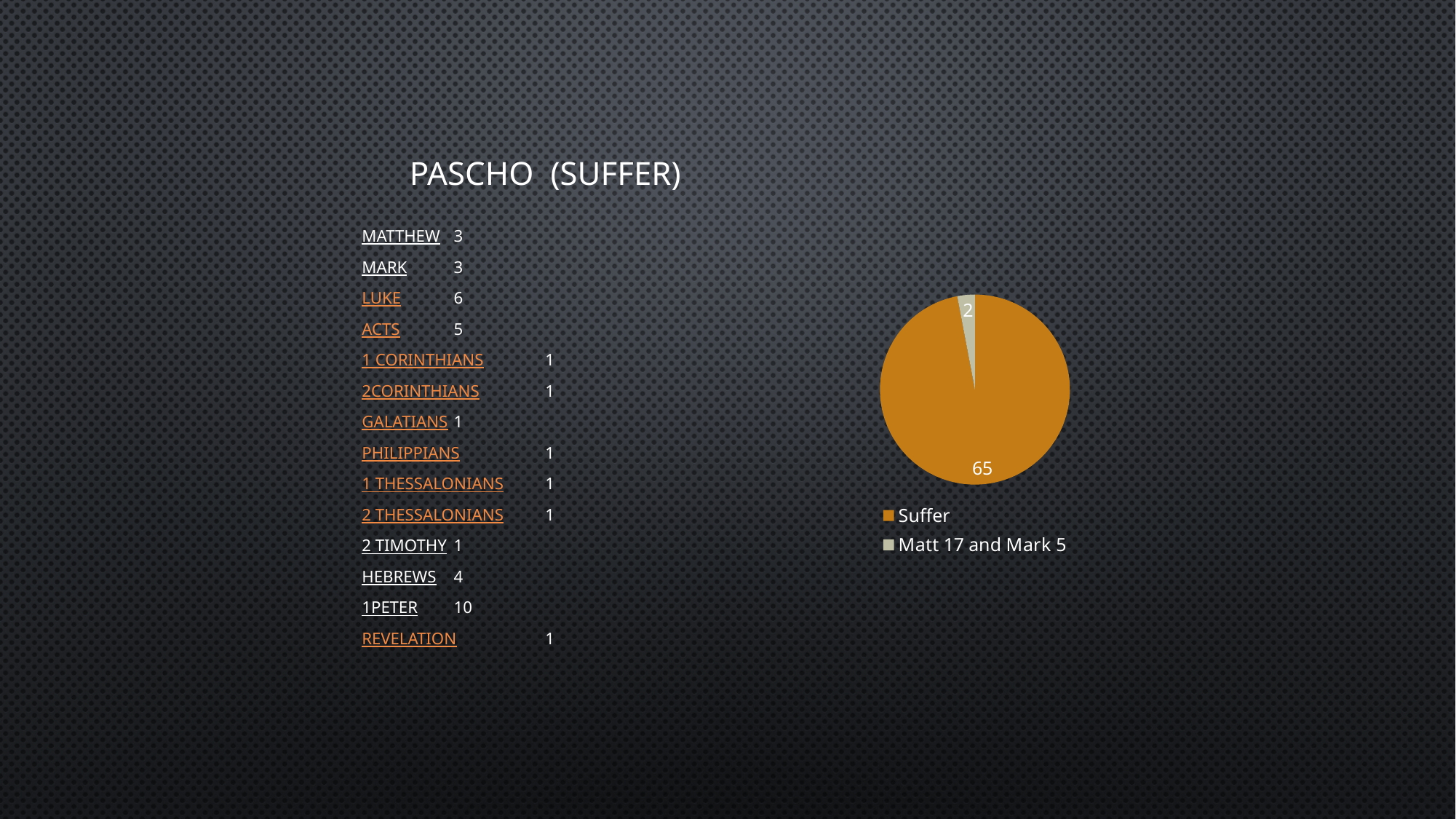
How many slices does the pie chart have? 2 What kind of chart is shown on the slide? Pie chart What are the two legend entries of the pie chart? Suffer; Matt 17 and Mark 5 How many entries does the pie chart's legend list? 2 What colour is the Suffer slice in the pie chart? Orange What is the difference between the Suffer value and the Matt 17 and Mark 5 value in the pie chart? 63 What value is shown for the Matt 17 and Mark 5 slice of the pie chart? 2 Which is larger in the pie chart, Suffer or Matt 17 and Mark 5? Suffer Which slice of the pie chart is the smallest? Matt 17 and Mark 5 Which slice of the pie chart is the largest? Suffer What value is shown for the Suffer slice of the pie chart? 65 What is the total of the two values shown in the pie chart? 67